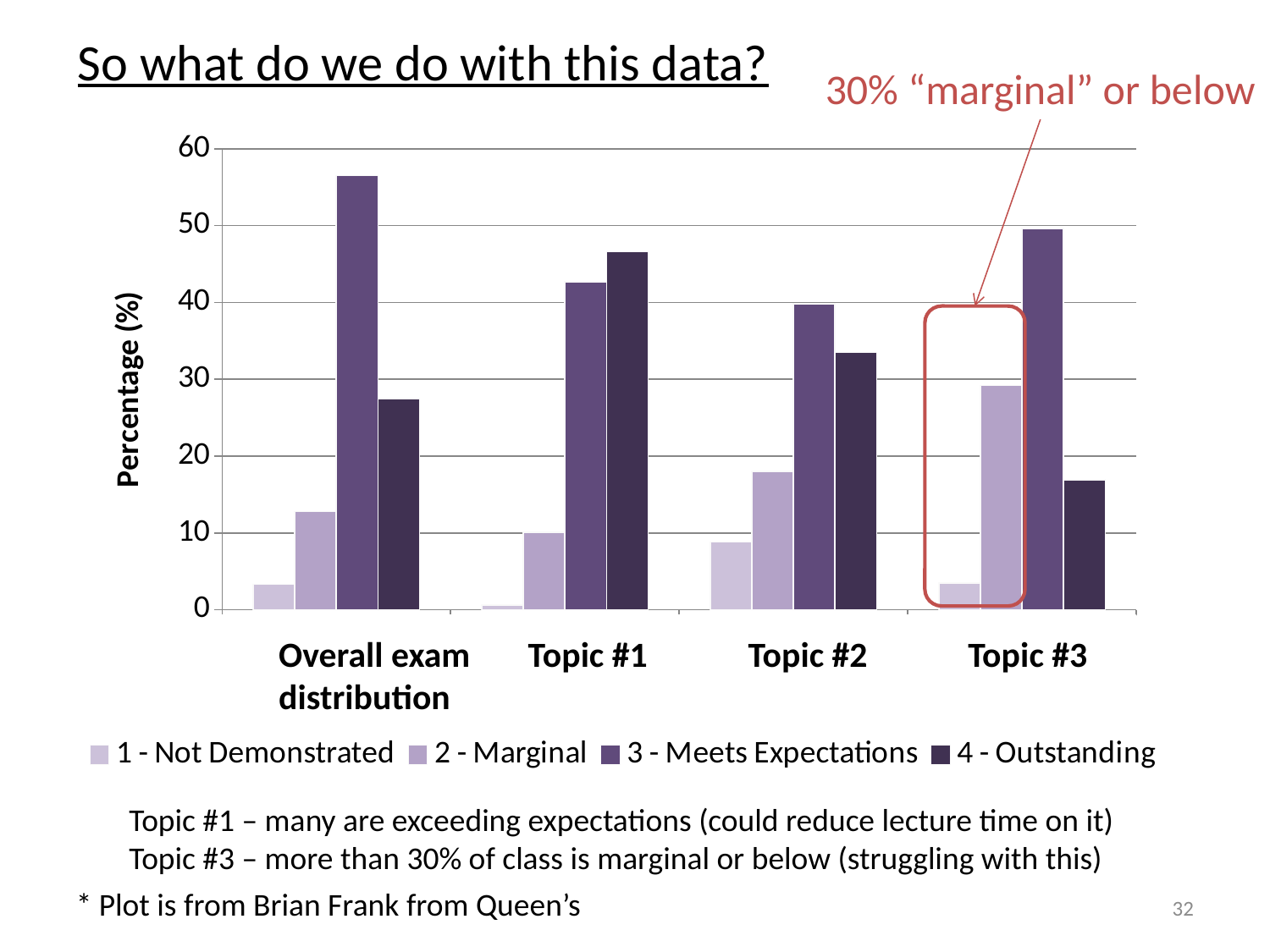
How many categories are shown along the x axis of the chart? 4 Which is larger, the 4 - Outstanding value for Topic #1 or for Topic #2? Topic #1 What kind of chart is shown on the slide? bar chart Is the value for 4 - Outstanding in Topic #1 greater or less than 40? greater In which category is the 3 - Meets Expectations bar the highest? Overall exam distribution Is the value for 3 - Meets Expectations in Overall exam distribution greater or less than 50? greater What is the title of the chart's vertical axis? Percentage (%) Is the value for 4 - Outstanding in Topic #3 greater or less than 20? less Which series is shown in the lightest shade in the legend? 1 - Not Demonstrated How many series does the chart's legend list? 4 In which category is the 2 - Marginal bar the highest? Topic #3